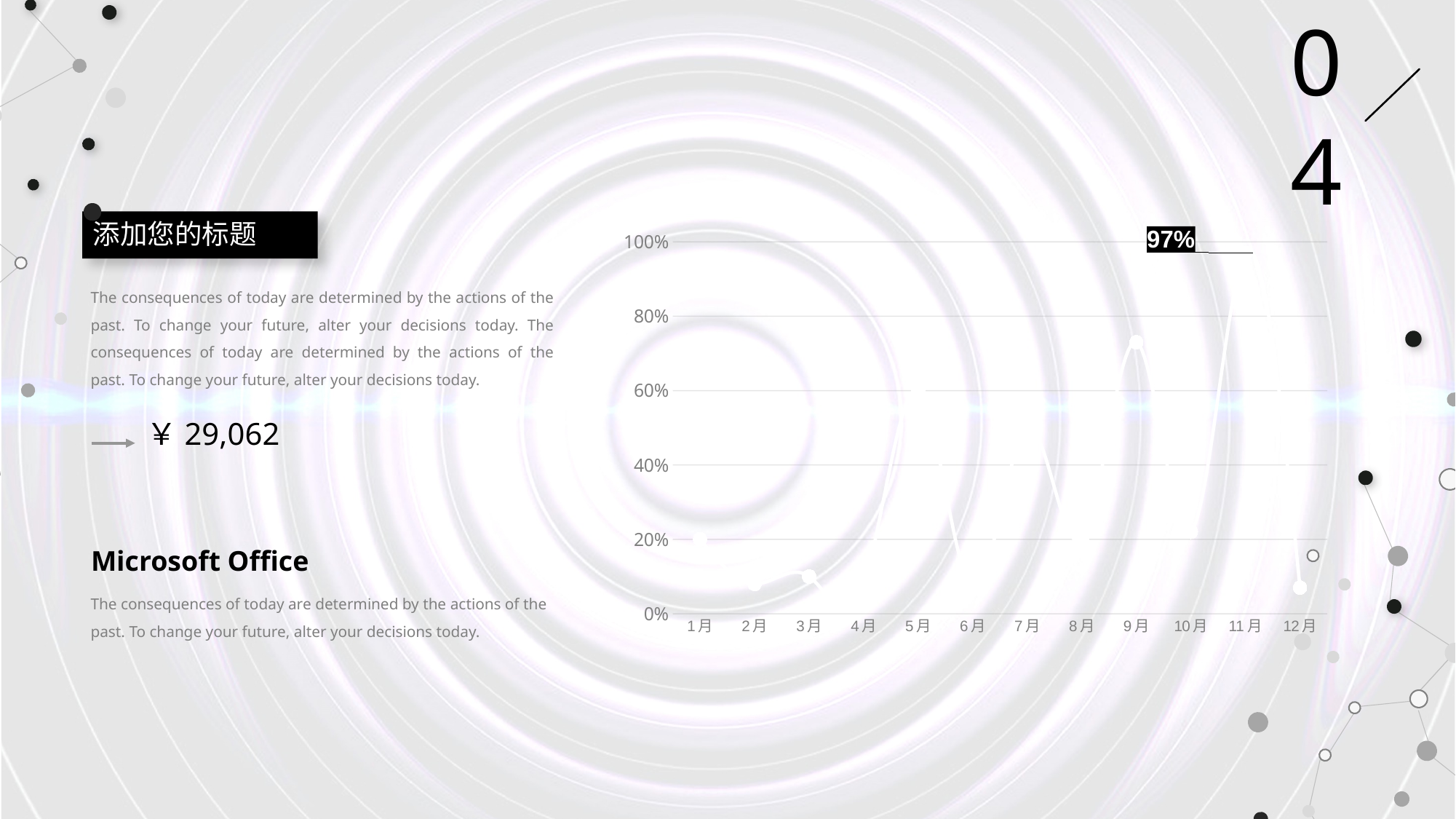
What is the highest value shown on the chart's y axis? 100% Which is larger, the value for 9月 or the value for 2月? 9月 Is the value for 12月 greater or less than 20%? less How many months are shown on the x axis of the chart? 12 Is the value for 9月 greater or less than 60%? greater What is the first category label on the x axis of the chart? 1月 What is the only value printed as a data label on the chart? 97% Is the value for 1月 greater or less than 40%? less What kind of chart is shown on the slide? line chart Does the line rise or fall from 1月 to 2月? fall